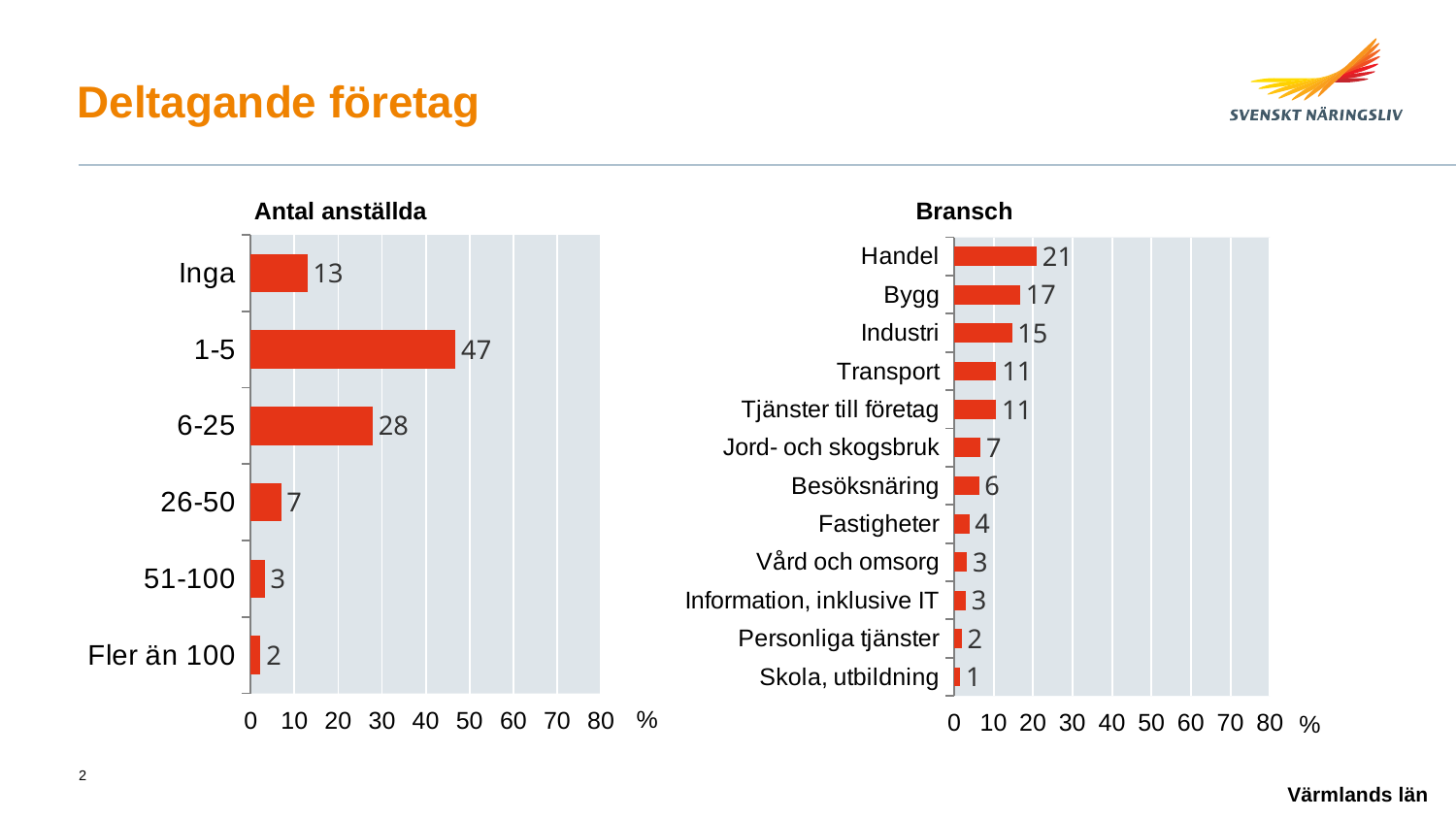
In the 'Antal anställda' chart, which category has the highest value? 1-5 In the 'Antal anställda' chart, what is the value for 1-5? 47 In the 'Bransch' chart, what is the value for Industri? 15 In the 'Antal anställda' chart, what is the difference between the values for 1-5 and 6-25? 19 In the 'Antal anställda' chart, which category has the lowest value? Fler än 100 In the 'Bransch' chart, which category has the highest value? Handel In the 'Bransch' chart, which category has the lowest value? Skola, utbildning In the 'Bransch' chart, which is larger, the value for Bygg or the value for Transport? Bygg In the 'Bransch' chart, what is the difference between the values for Handel and Bygg? 4 In the 'Bransch' chart, how many categories are shown? 12 In the 'Antal anställda' chart, how many categories are shown? 6 What kind of chart is the 'Bransch' chart? Bar chart